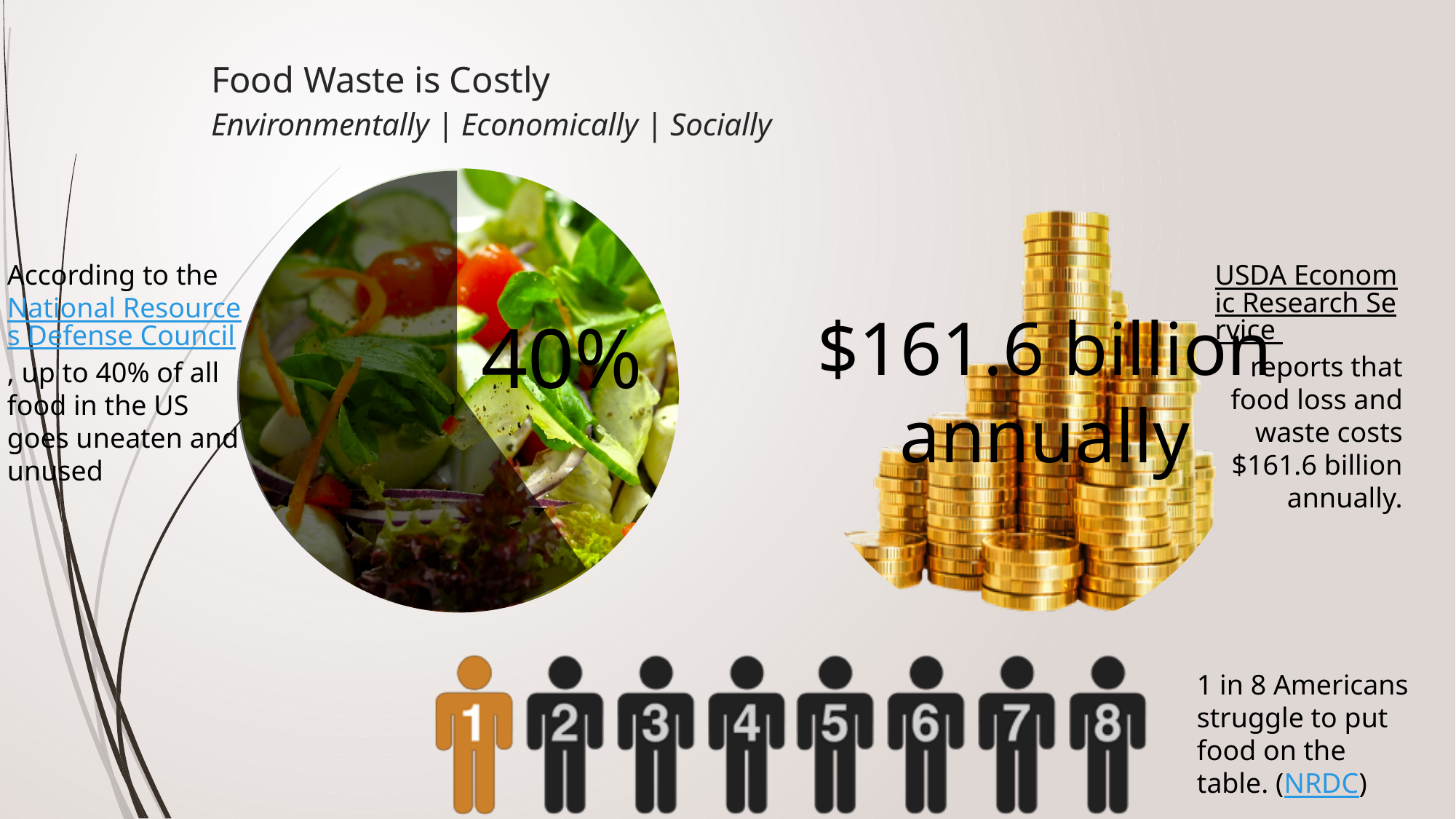
In the pictogram at the bottom of the slide, how many of the person figures are highlighted in orange? 1 What is the title of the slide containing the pie graphic? Food Waste is Costly What annual cost of food loss and waste is printed over the coin image on the right of the slide? $161.6 billion annually What kind of chart is the circular salad graphic on the left of the slide? pie chart How many person figures are shown in the pictogram at the bottom of the slide? 8 What number is printed on the orange-highlighted figure in the pictogram at the bottom of the slide? 1 What percentage is printed on the circular pie graphic on the left of the slide? 40% Is the share shown on the pie graphic on the left greater or less than 50%? less According to the pie graphic on the left, what share of all food in the US goes uneaten and unused? 40% What ratio of Americans does the pictogram at the bottom of the slide represent as struggling to put food on the table? 1 in 8